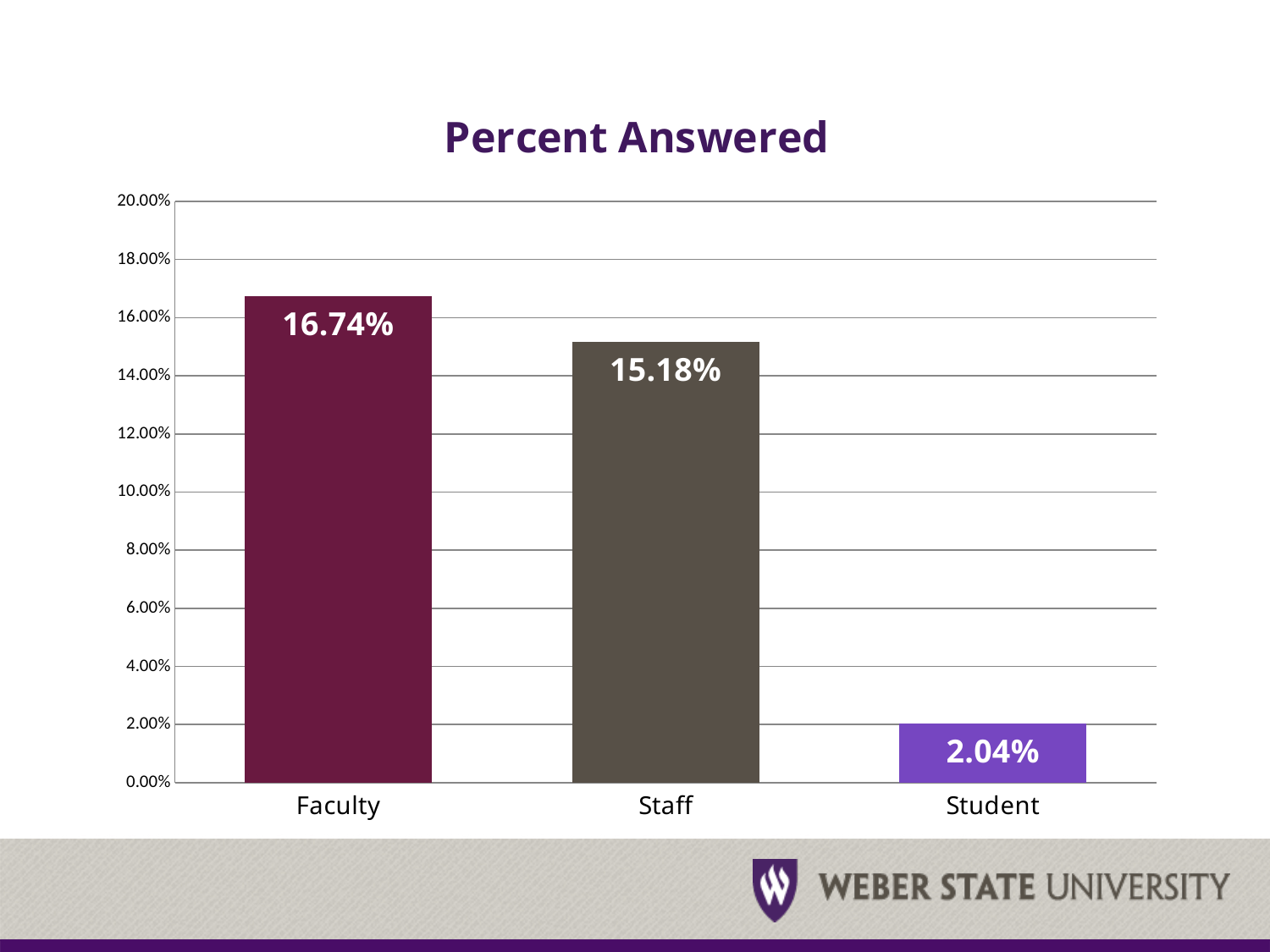
Is the value for Student greater or less than 4.00%? less Which category has the lowest percent answered? Student What kind of chart is shown on the slide? bar chart Which has a higher percent answered, Staff or Student? Staff What is the difference in percent answered between Staff and Student? 13.14% What is the percent answered for Faculty? 16.74% Which category has the highest percent answered? Faculty What is the percent answered for Staff? 15.18% What is the percent answered for Student? 2.04% What is the title of the chart? Percent Answered How many categories are shown on the x axis? 3 What is the difference in percent answered between Faculty and Staff? 1.56%